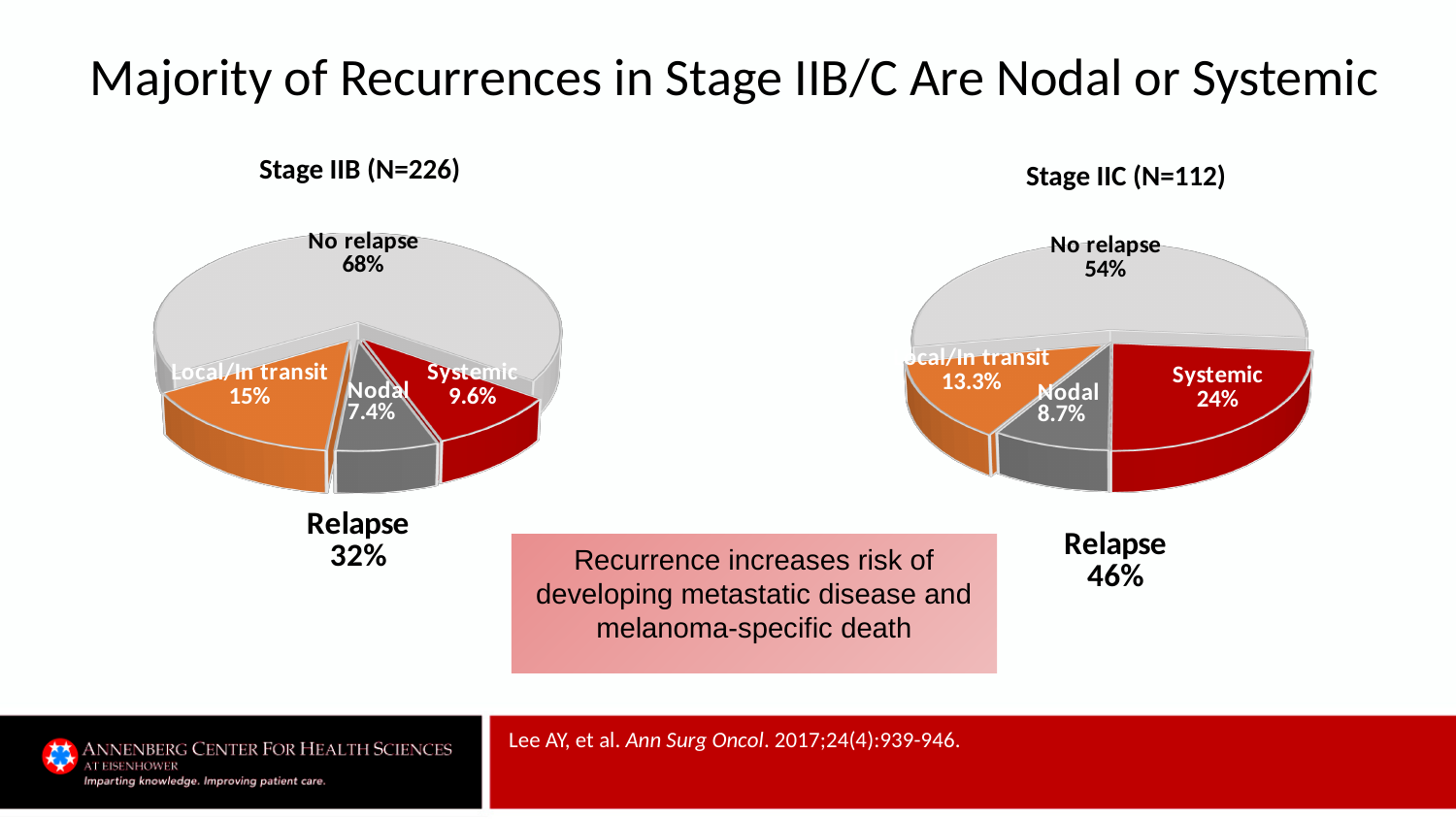
Which is larger: the Nodal share in the Stage IIB chart or the Nodal share in the Stage IIC chart? Stage IIC What colour is the Systemic slice in both pie charts? Red What is the total relapse percentage shown below the Stage IIC (N=112) chart? 46% What type of chart is used for Stage IIC (N=112)? Pie chart In the Stage IIC (N=112) chart, what is the value for Local/In transit? 13.3% In the Stage IIB (N=226) chart, which relapse category has the largest share? Local/In transit What is the difference between the Systemic share in the Stage IIC chart and the Systemic share in the Stage IIB chart? 14.4% How many slices does the Stage IIB (N=226) pie chart have? 4 In the Stage IIC (N=112) chart, what percentage of recurrences were systemic? 24% In the Stage IIC (N=112) chart, which category has the smallest slice? Nodal In the Stage IIB (N=226) chart, what is the value for Nodal? 7.4% In the Stage IIB (N=226) chart, what share of patients had no relapse? 68%